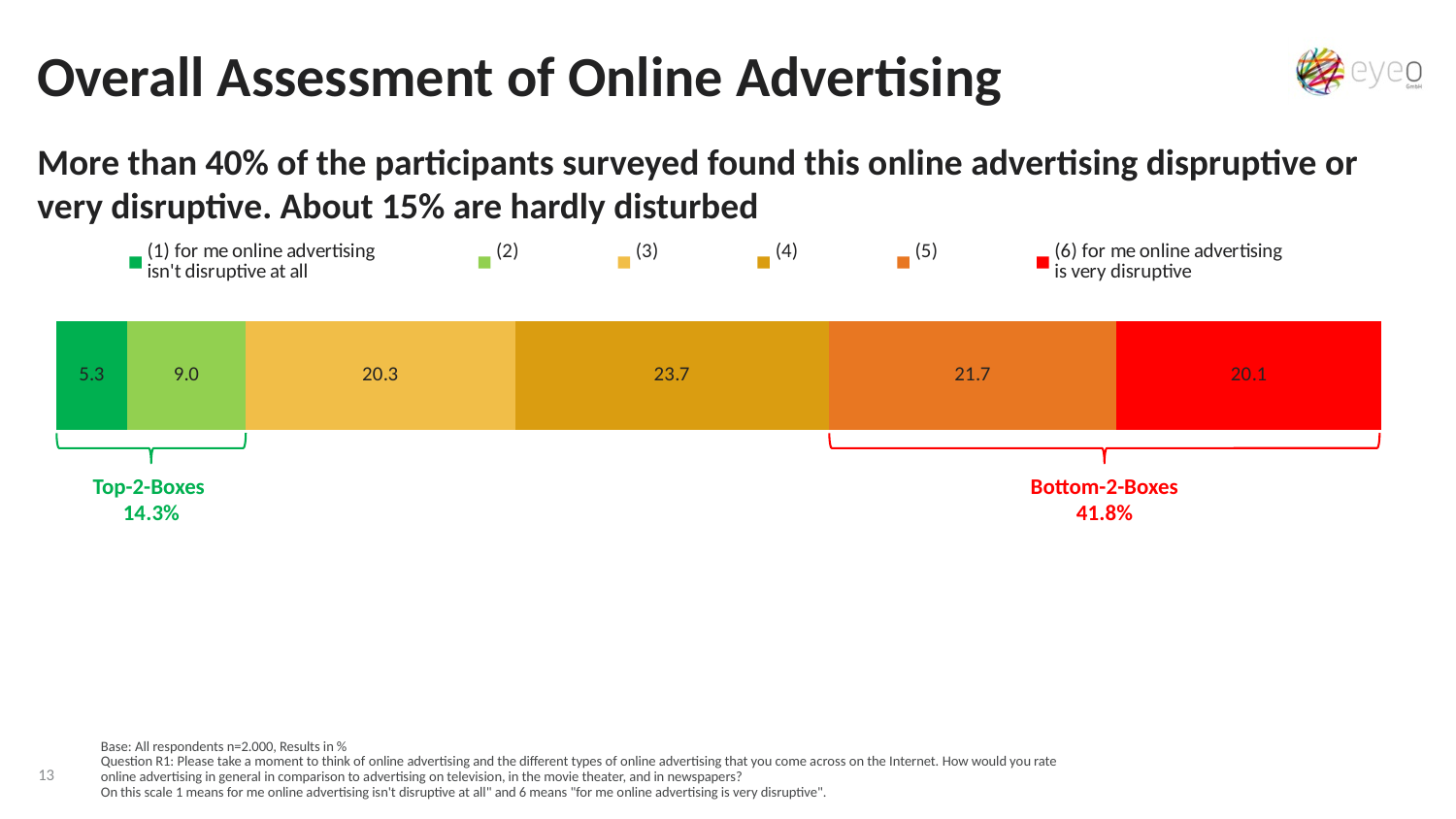
What value is shown for the (4) segment of the bar? 23.7 What is the combined value of the (5) and (6) segments, labelled Bottom-2-Boxes? 41.8% What is the difference between the (4) segment and the (5) segment? 2.0 What is the combined value of the (1) and (2) segments, labelled Top-2-Boxes? 14.3% How many series does the legend list? 6 What percentage of respondents chose (1) for me online advertising isn't disruptive at all? 5.3 What kind of chart is shown on the slide? Stacked bar chart What value is shown for the (6) for me online advertising is very disruptive segment? 20.1 Which rating segment has the smallest value? (1) for me online advertising isn't disruptive at all What colour is the segment for (6) for me online advertising is very disruptive? Red Which is larger, the (3) segment or the (6) segment? (3) Which rating segment has the largest value? (4)